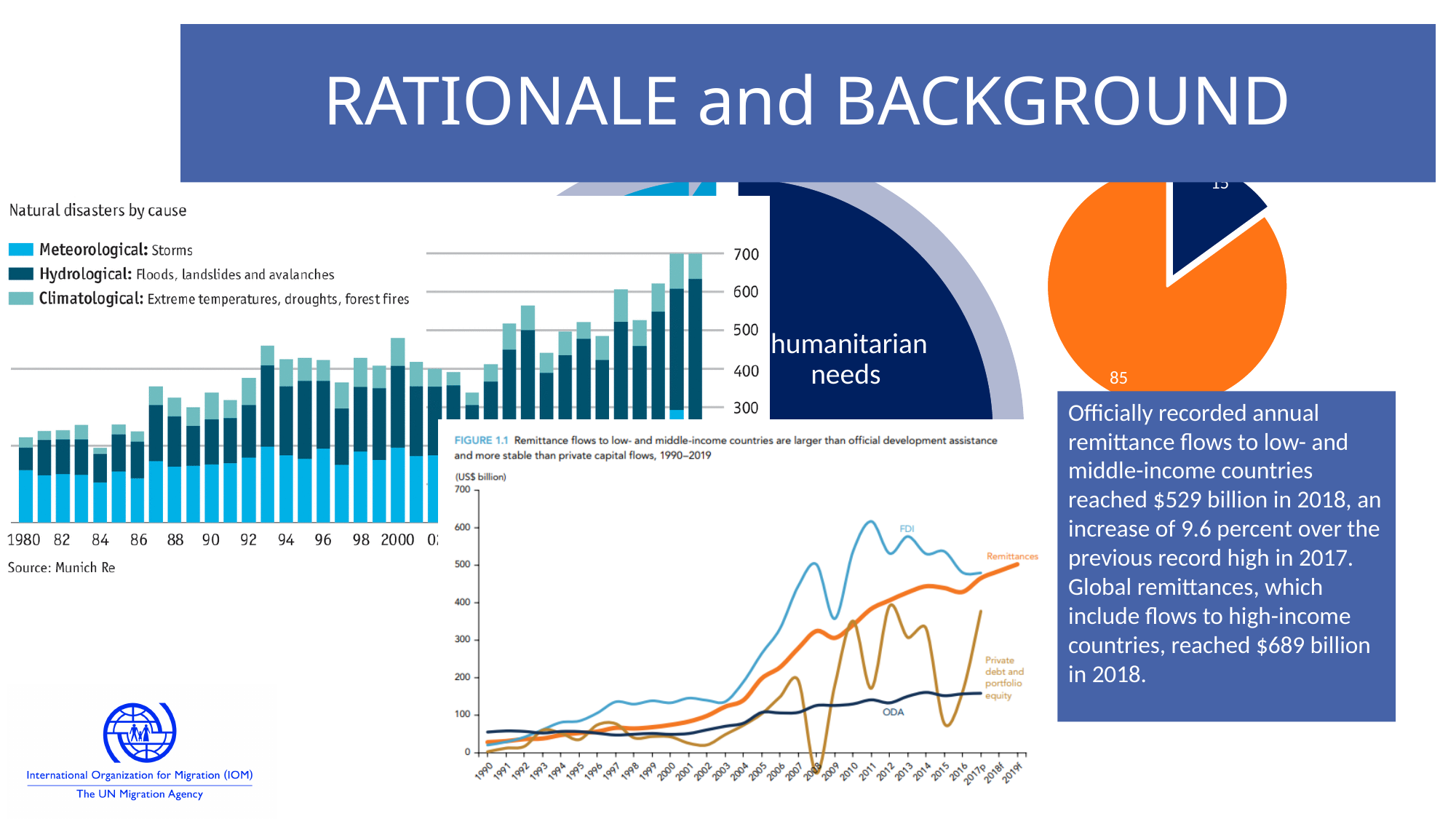
In the 'Natural disasters by cause' chart, is the total for 1980 greater or less than 300? less What kind of chart is the 'Natural disasters by cause' chart on the left of the slide? bar chart How many slices does the pie chart on the right of the slide have? 2 In Figure 1.1, is the value of Remittances in 2019f greater or less than 400? greater How many series are plotted in Figure 1.1 on remittance flows? 4 How many categories does the legend of the 'Natural disasters by cause' chart list? 3 In the 'Natural disasters by cause' chart, do the bar totals generally rise or fall from 1980 onward? rise In the pie chart on the right of the slide, what value is shown for the larger orange slice? 85 In Figure 1.1, which series is higher in 2011, FDI or Remittances? FDI What kind of chart is Figure 1.1 on remittance flows? line chart In the 'Natural disasters by cause' chart, which category covers floods, landslides and avalanches? Hydrological What source is cited for the 'Natural disasters by cause' chart? Munich Re